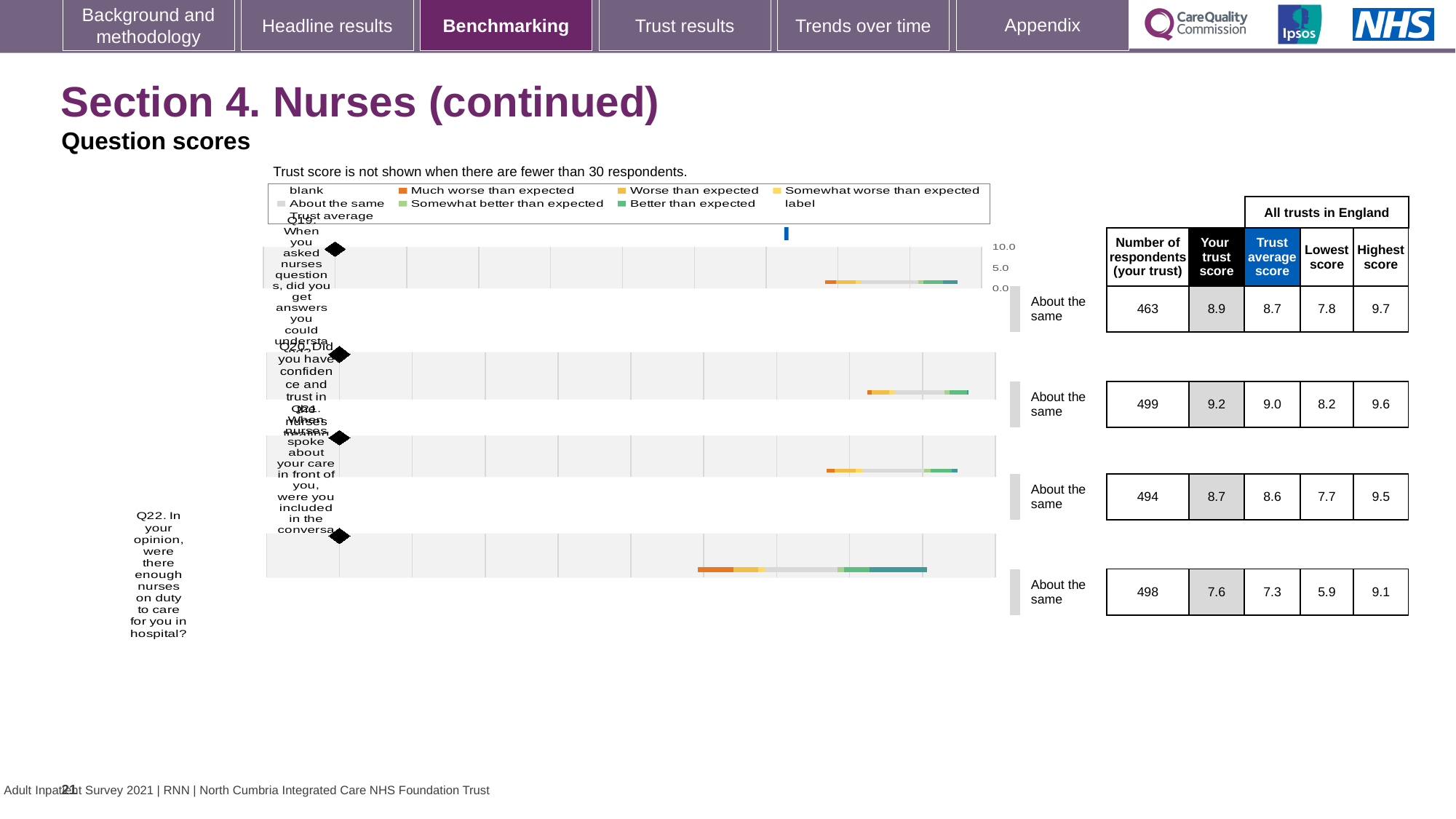
What is the difference between the highest and lowest scores among all trusts in England for Q20? 1.4 What is the difference between the trust score and the trust average score for Q22? 0.3 What is the trust score for Q22 (were there enough nurses on duty to care for you in hospital)? 7.6 What is the highest score among all trusts in England for Q20? 9.6 What benchmark category is shown for each of the four questions on this slide? About the same How many respondents from the trust answered Q19? 463 For Q19, which is larger: the trust score or the trust average score? Trust score Which question has the lowest trust score? Q22 How many questions (categories) are plotted in the chart? 4 What is the lowest score among all trusts in England for Q22? 5.9 What kind of chart is used to show the question scores on this slide? Bar chart Which question has the highest trust score? Q20